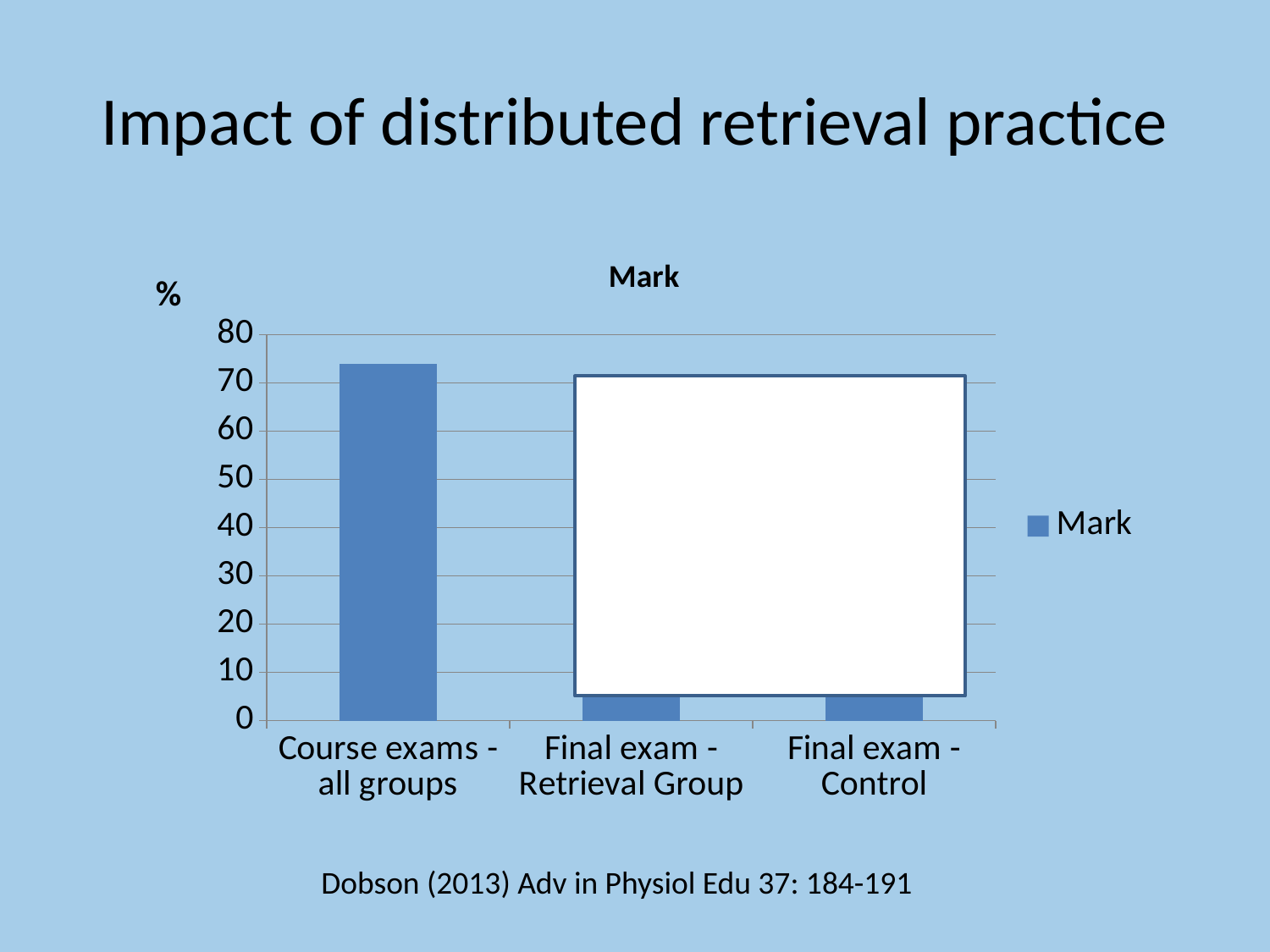
What label is shown on the y axis of the chart? % How many categories are shown on the x axis of the chart? 3 Is the value for Course exams - all groups greater or less than 80? less What kind of chart is shown on the slide? bar chart How many series does the chart's legend list? 1 Is the value for Course exams - all groups greater or less than 70? greater What is the title of the chart? Mark Is the value for Course exams - all groups greater or less than 50? greater